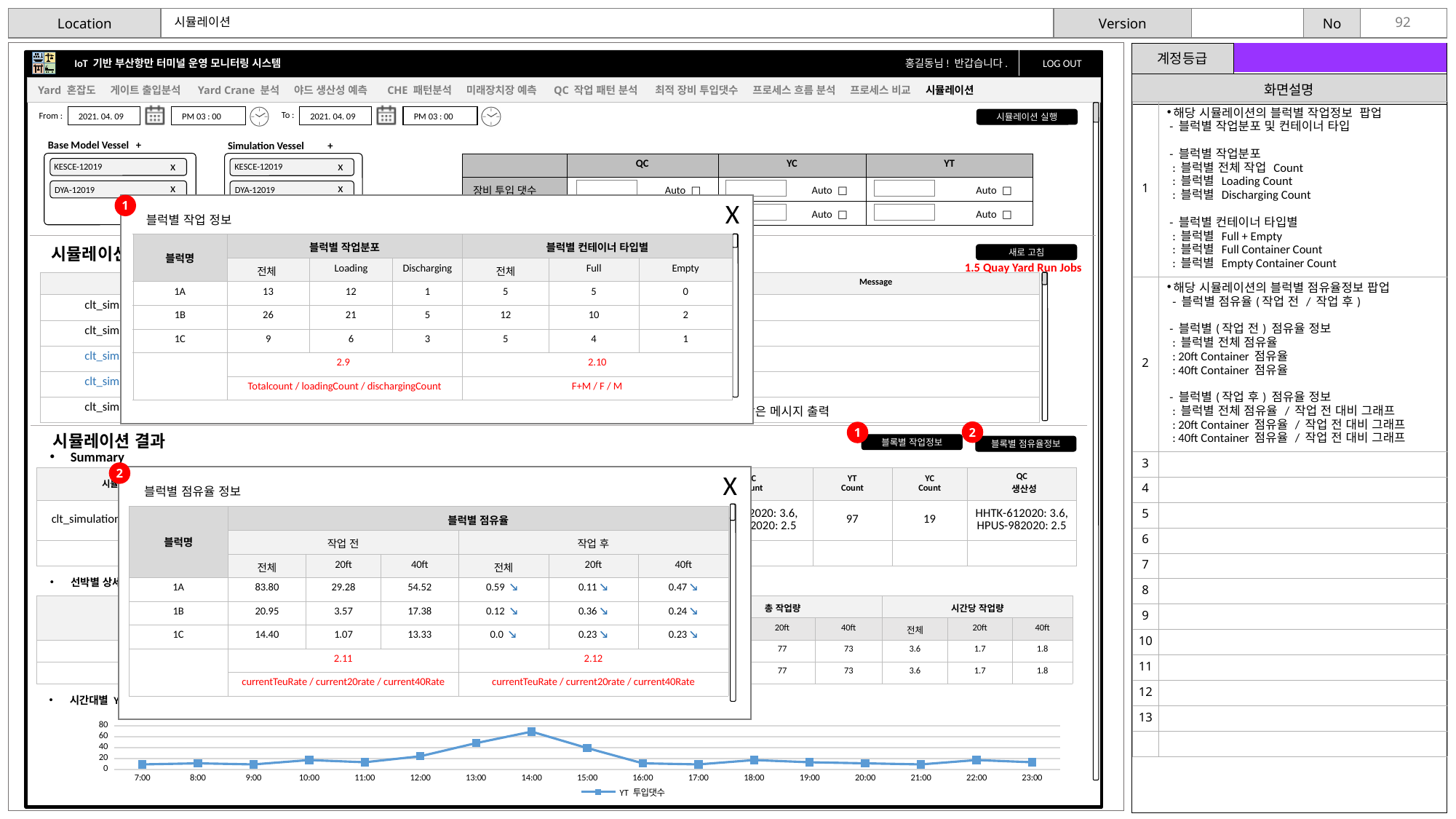
In the line chart, which is larger, the value at 13:00 or the value at 14:00? 14:00 Is the value for 7:00 in the line chart greater or less than 20? less In the line chart, which is larger, the value at 15:00 or the value at 16:00? 15:00 What kind of chart is shown at the bottom of the slide? line chart Is the value for 17:00 in the line chart greater or less than 20? less How many series does the legend of the line chart list? 1 At which time does the line chart reach its highest value? 14:00 Is the value for 13:00 in the line chart greater or less than 40? greater How many time points are plotted along the x axis of the line chart? 17 What is the name of the series shown in the line chart's legend? YT 투입댓수 In the line chart, do the values rise or fall from 14:00 to 16:00? fall